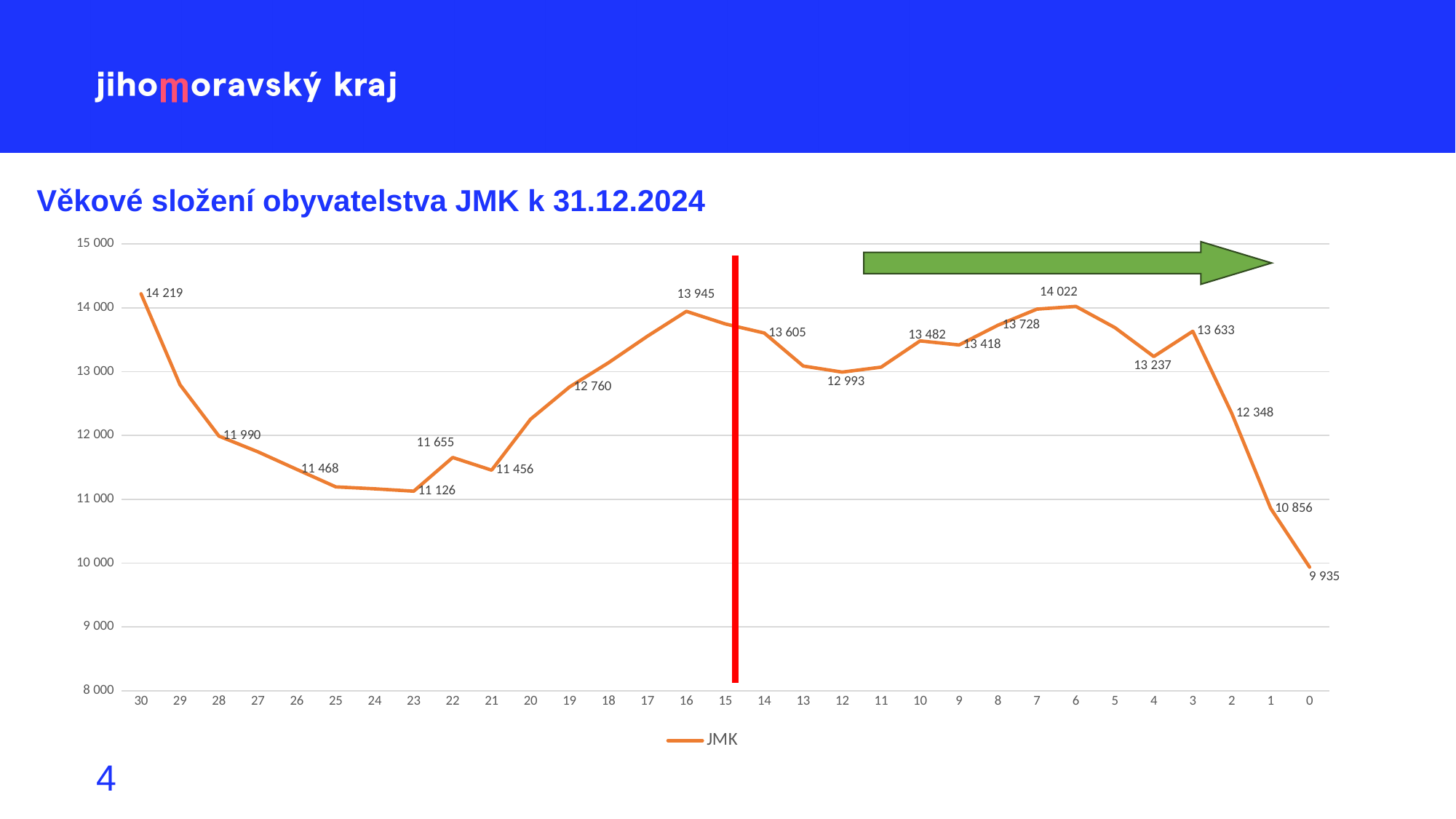
Is the value for age 29 greater or less than 13 000? less Which age has the highest value? 30 Which age has the lowest value? 0 What is the difference between the values for age 16 and age 19? 1 185 What is the value for age 0? 9 935 What is the value for age 6? 14 022 What is the value for age 23? 11 126 What is the name of the series in the legend? JMK Which is larger, the value for age 22 or the value for age 21? age 22 What is the value for age 30? 14 219 How many series does the legend list? 1 What type of chart is shown on the slide? line chart